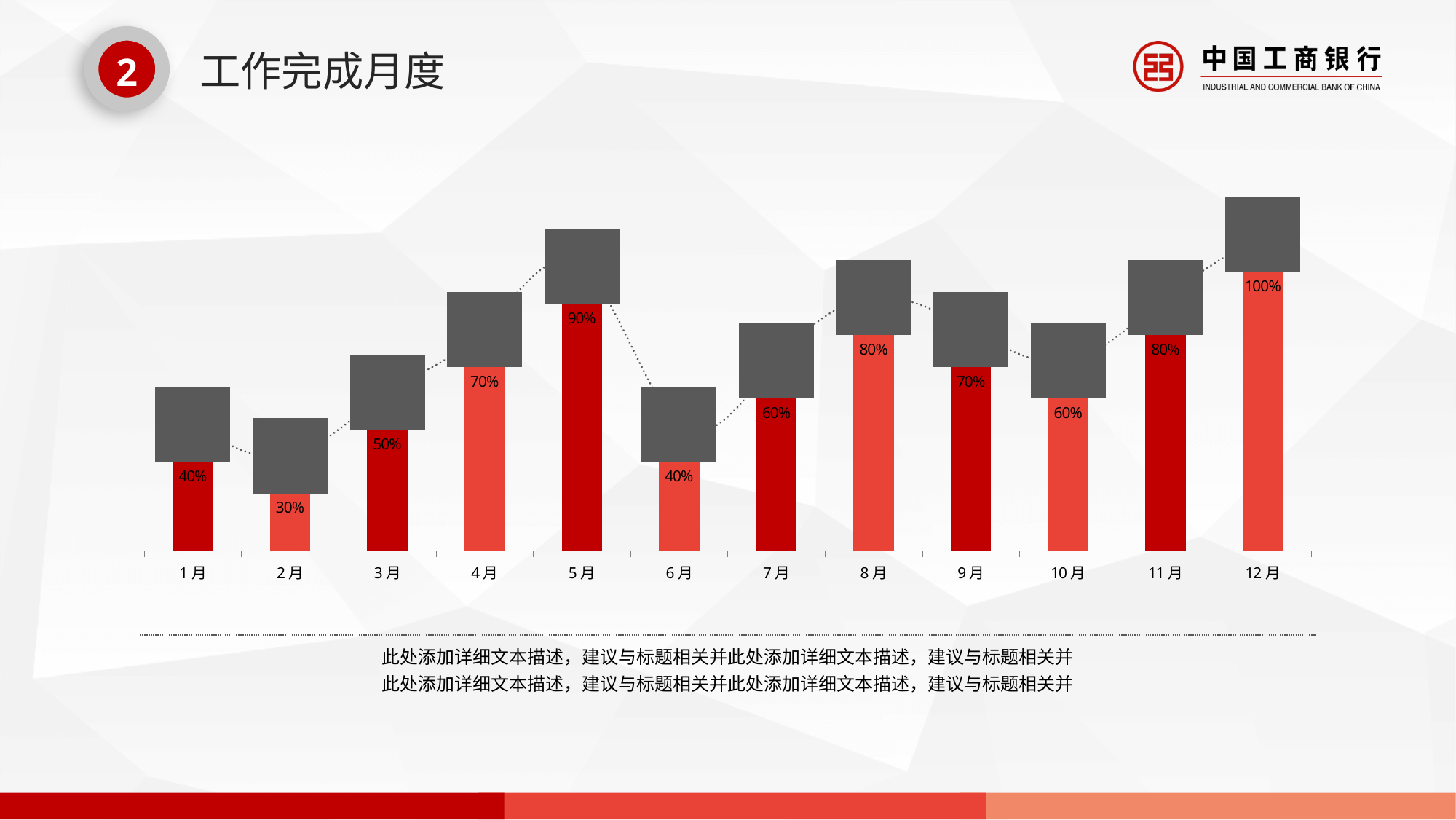
What is the difference between the values for 5月 and 6月? 50% What is the value for 2月? 30% What is the value for 10月? 60% How many months are shown on the x axis? 12 Which month has the lowest value? 2月 What is the value for 5月? 90% Which is larger, the value for 4月 or the value for 7月? 4月 Do the values rise or fall from 1月 to 5月? rise What kind of chart is shown on the slide? bar chart What is the title of the chart on the slide? 工作完成月度 What is the difference between the values for 12月 and 1月? 60% Which month has the highest value? 12月